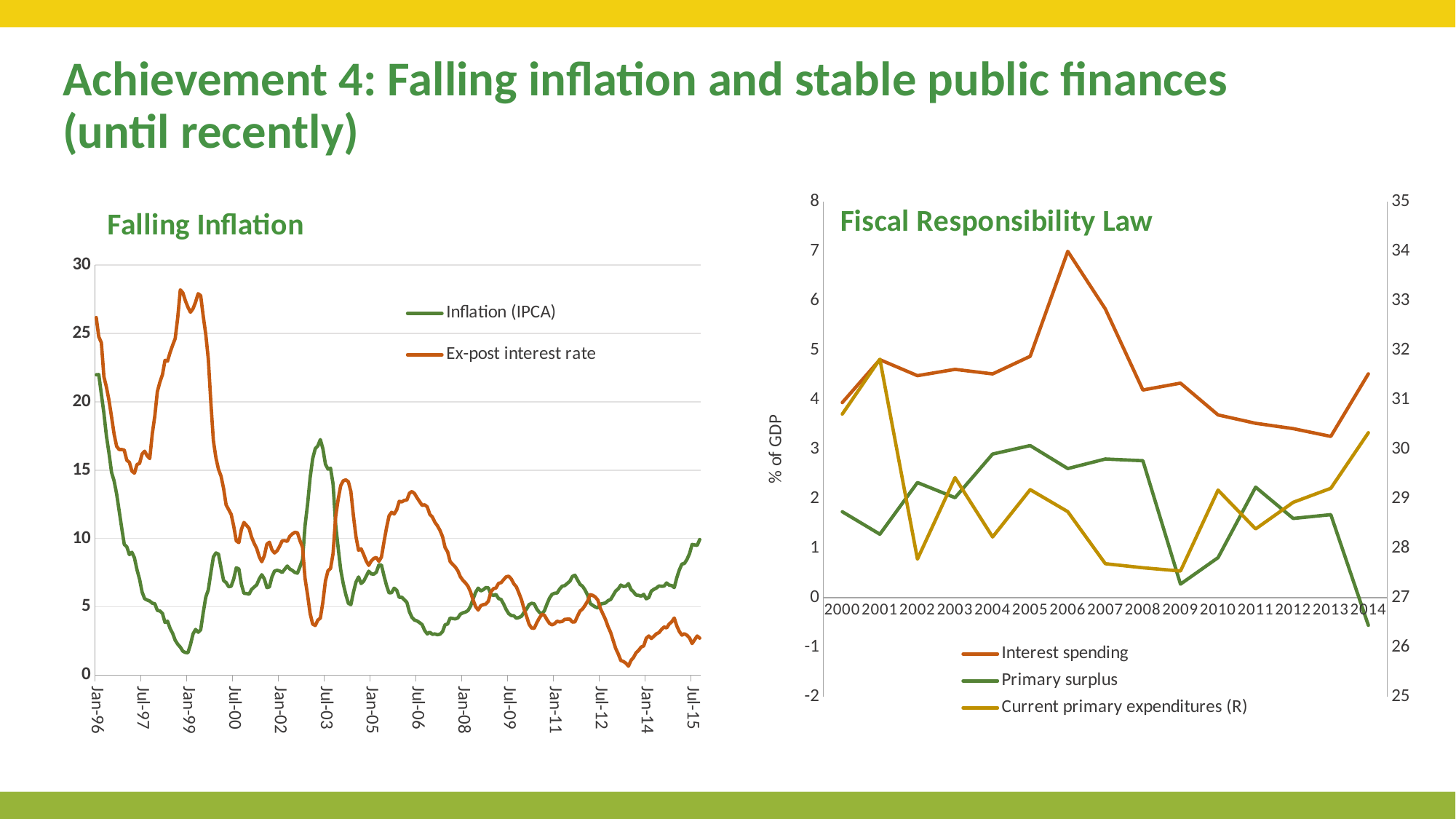
In the "Fiscal Responsibility Law" chart, is the value of Interest spending in 2006 greater or less than 6? greater In the "Fiscal Responsibility Law" chart, is the value of Primary surplus in 2014 greater or less than 0? less In the "Falling Inflation" chart, which series is higher at Jan-99, Inflation (IPCA) or Ex-post interest rate? Ex-post interest rate How many series does the legend of the "Fiscal Responsibility Law" chart list? 3 How many years are shown on the x axis of the "Fiscal Responsibility Law" chart? 15 What kind of chart is the "Falling Inflation" chart? line chart In the "Fiscal Responsibility Law" chart, in which year is Primary surplus lowest? 2014 In the "Fiscal Responsibility Law" chart, in which year is Interest spending highest? 2006 In the "Falling Inflation" chart, does Inflation (IPCA) rise or fall between Jan-96 and Jan-99? fall In the "Falling Inflation" chart, is the value of the Ex-post interest rate at Jan-96 greater or less than 25? greater How many series does the legend of the "Falling Inflation" chart list? 2